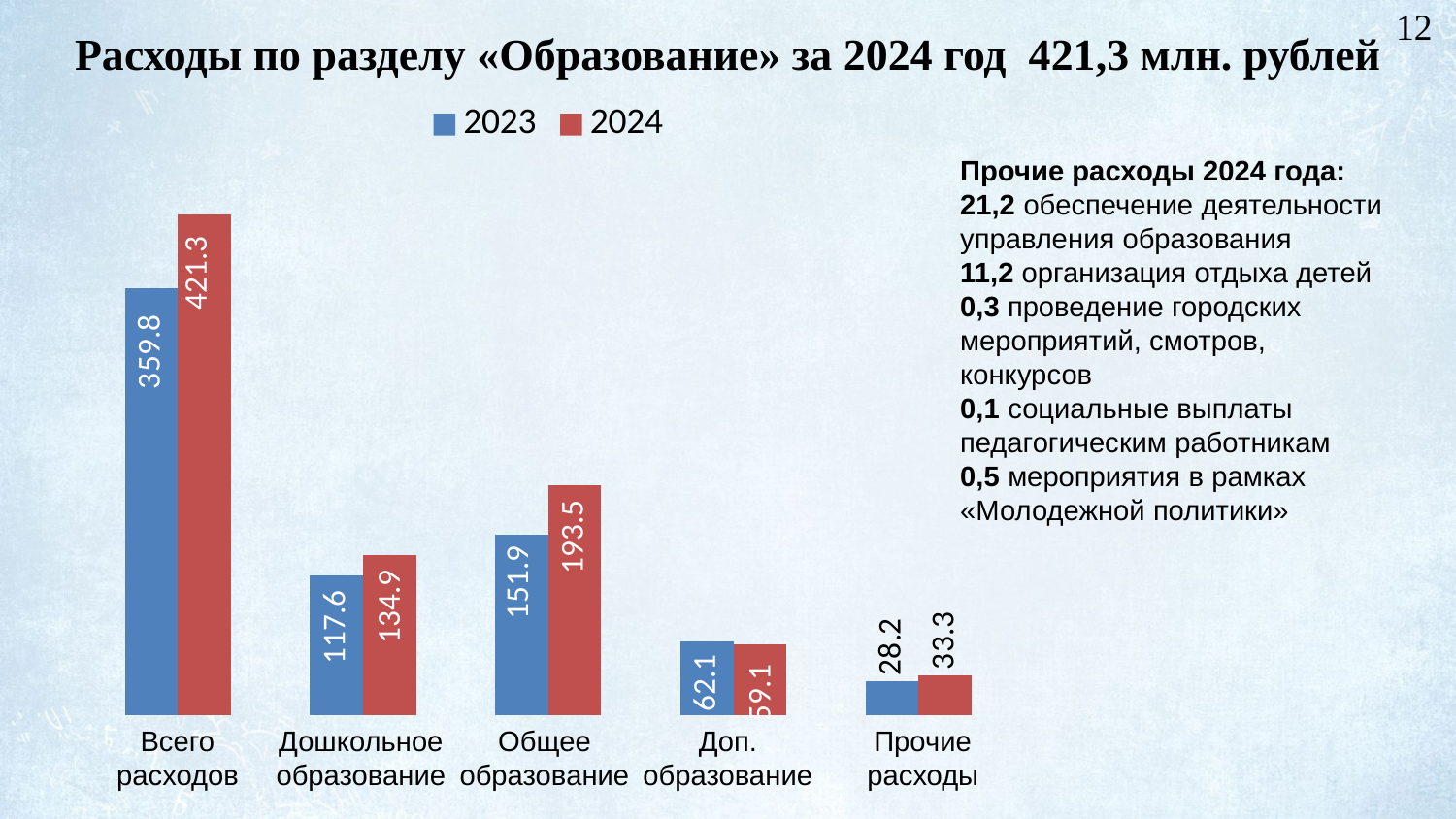
What is the 2024 value for Всего расходов? 421.3 What is the 2023 value for Прочие расходы? 28.2 Excluding Всего расходов, which category has the highest 2024 value? Общее образование Which category has the lowest 2023 value? Прочие расходы What is the difference between the 2024 and 2023 values for Всего расходов? 61.5 What is the difference between the 2024 and 2023 values for Общее образование? 41.6 What is the 2023 value for Общее образование? 151.9 How many series does the legend list? 2 For Доп. образование, which year has the larger value, 2023 or 2024? 2023 How many categories are shown on the x axis? 5 What is the 2024 value for Дошкольное образование? 134.9 What kind of chart is shown on the slide? bar chart